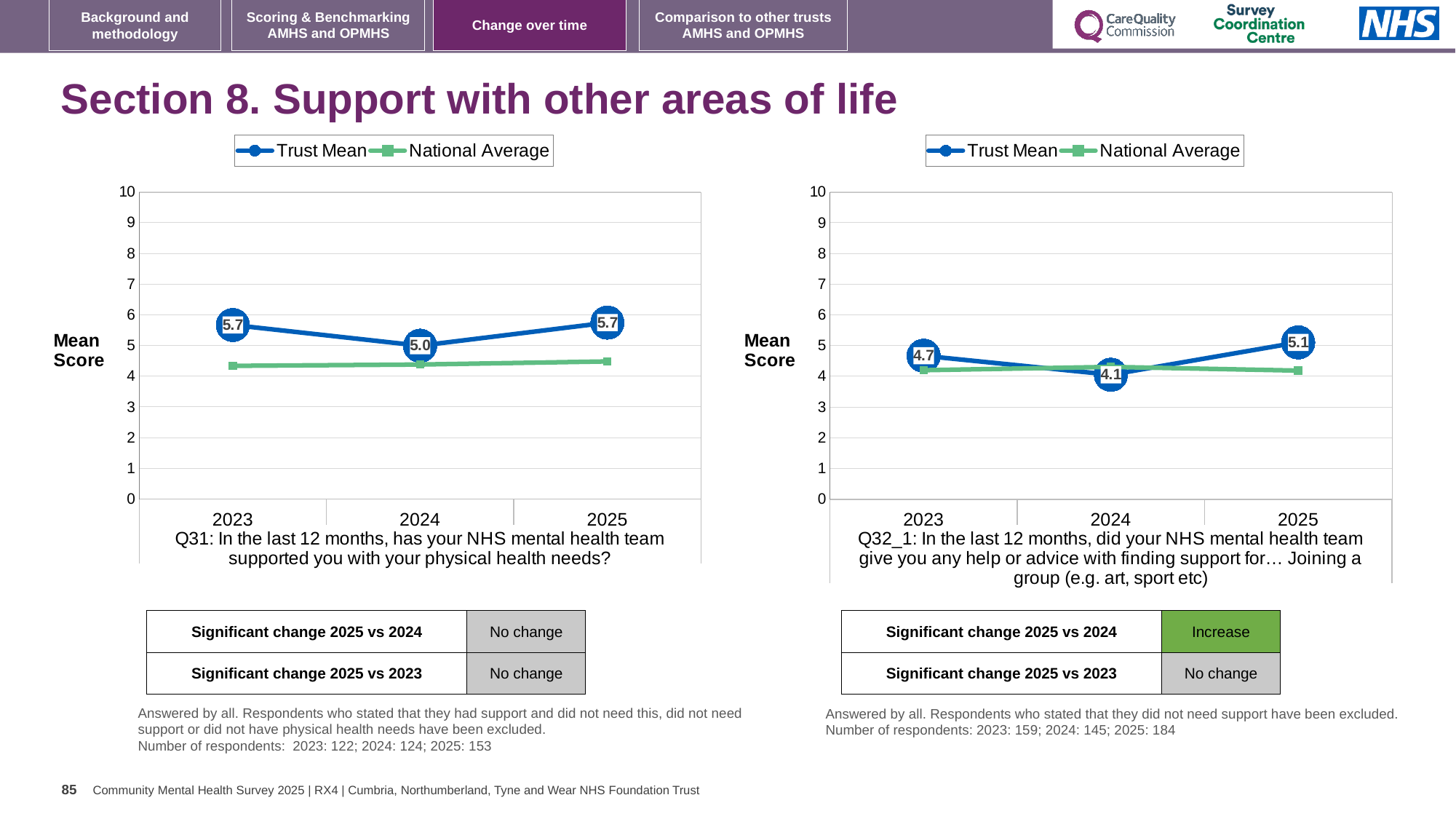
In the Q31 chart on the left, what is the Trust Mean for 2024? 5.0 In the Q32_1 chart on the right, which year has the highest Trust Mean? 2025 In the Q31 chart on the left, is the Trust Mean for 2025 larger than the National Average for 2025? Yes In the Q31 chart on the left, what is the Trust Mean for 2025? 5.7 In the Q32_1 chart on the right, which year has the lowest Trust Mean? 2024 What kind of chart is the Q31 chart on the left? Line chart In the Q31 chart on the left, what is the difference between the Trust Mean in 2025 and in 2024? 0.7 How many series does the legend of the Q32_1 chart on the right list? 2 In the Q32_1 chart on the right, what is the Trust Mean for 2023? 4.7 In the Q31 chart on the left, is the National Average for 2023 greater or less than 5? less In the Q32_1 chart on the right, what is the Trust Mean for 2025? 5.1 In the Q32_1 chart on the right, what is the difference between the Trust Mean in 2025 and in 2024? 1.0